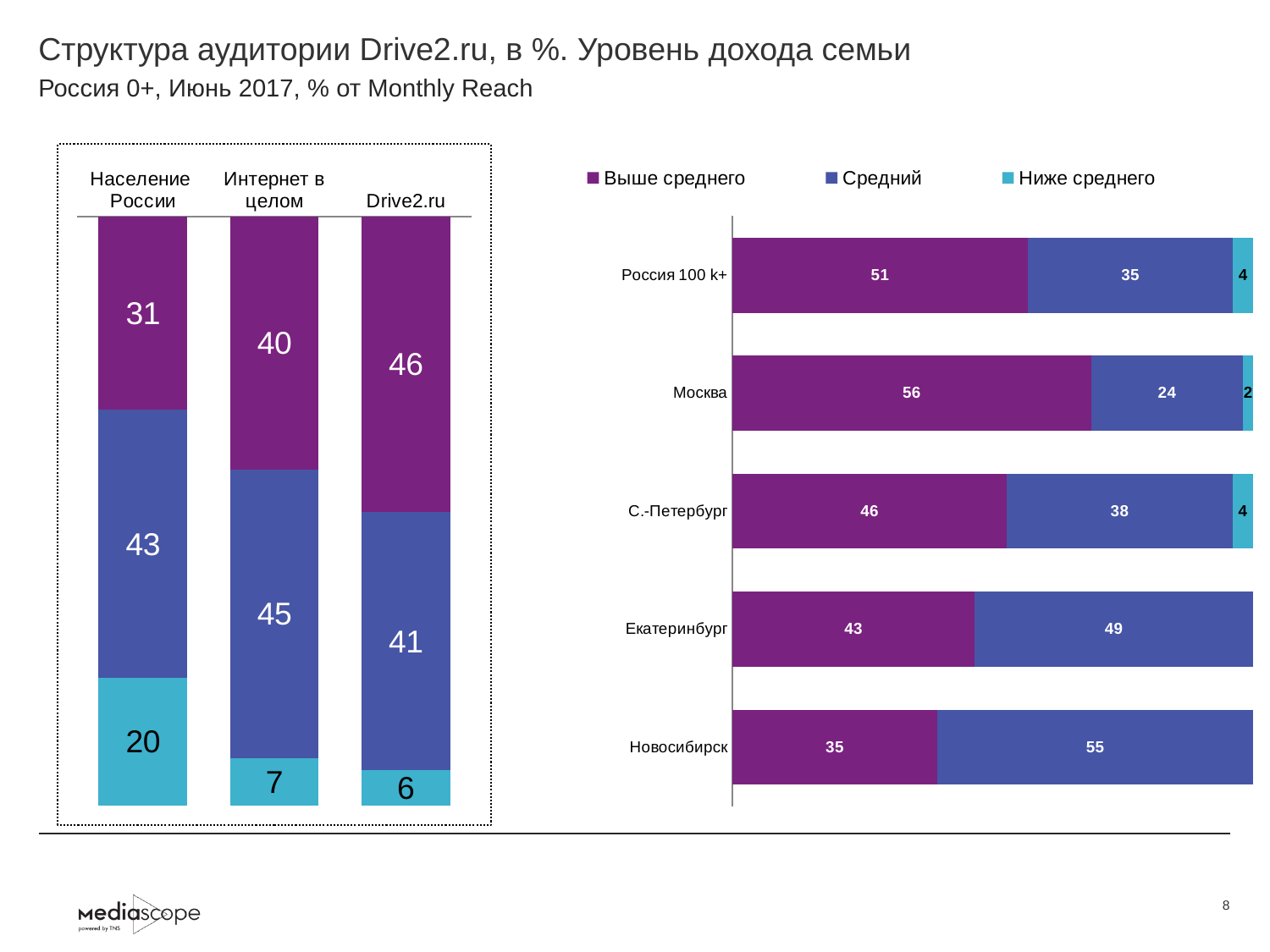
In the right chart, which category has the highest Выше среднего value? Москва In the right chart, what is the Выше среднего value for Москва? 56 How many series does the legend of the right chart list? 3 In the left chart, what is the value of the middle (blue) segment for Интернет в целом? 45 In the left chart, what is the value of the bottom (light blue) segment for Население России? 20 How many categories are shown in the right chart? 5 In the left chart, which category has the smallest bottom (light blue) segment? Drive2.ru In the left chart, what is the value of the top (purple) segment for Drive2.ru? 46 In the right chart, is the Выше среднего value larger for Россия 100 k+ or for С.-Петербург? Россия 100 k+ In the right chart, what is the Средний value for Новосибирск? 55 In the left chart, what is the difference between the top (purple) segments of Drive2.ru and Население России? 15 In the right chart, which category has the lowest Средний value? Москва